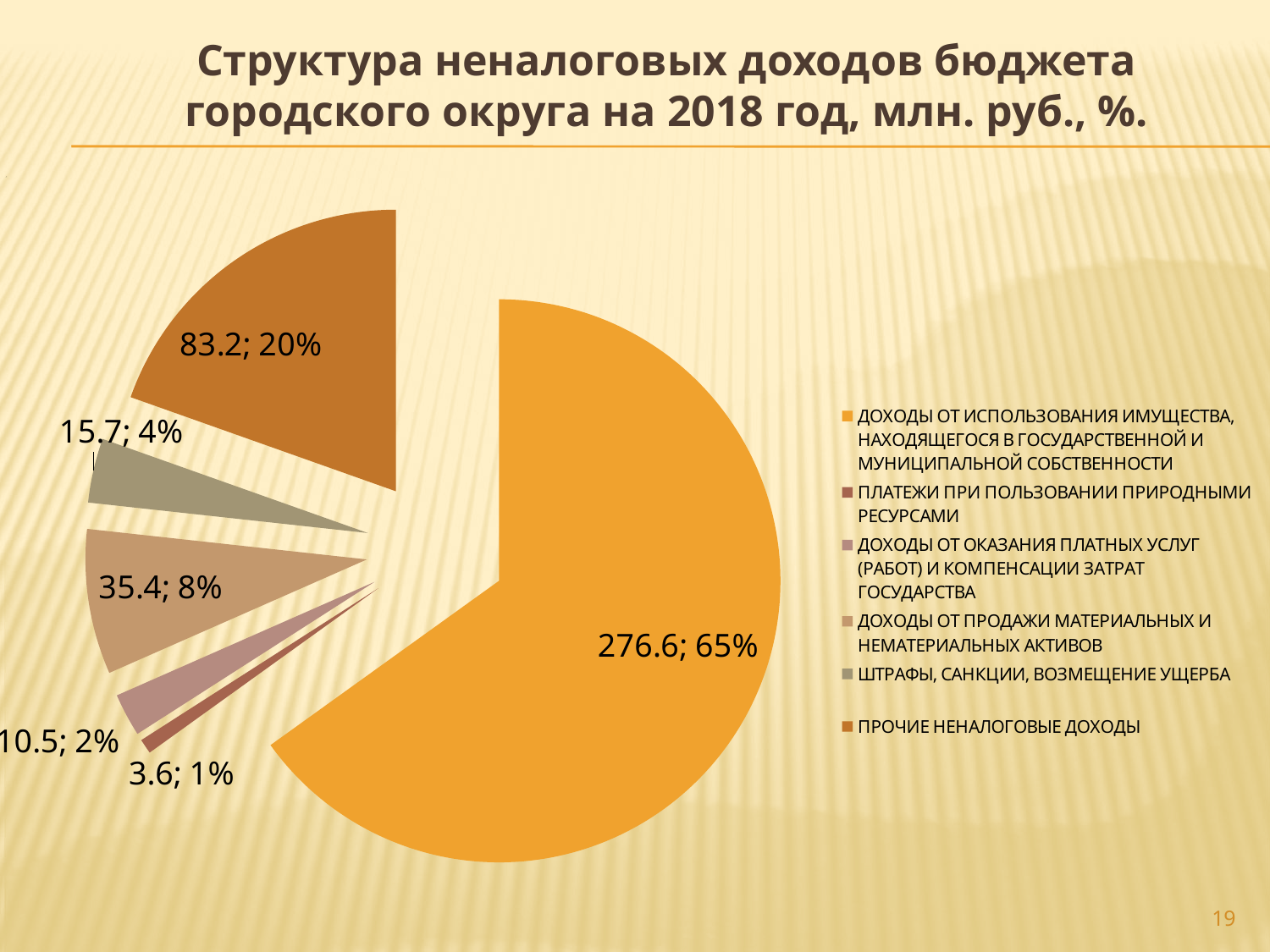
How many slices does the pie chart have? 6 Which category has the largest slice of the pie? Доходы от использования имущества, находящегося в государственной и муниципальной собственности What value is shown for the slice 'Прочие неналоговые доходы'? 83.2; 20% What value is shown for the slice 'Доходы от продажи материальных и нематериальных активов'? 35.4; 8% What value is shown for the slice 'Штрафы, санкции, возмещение ущерба'? 15.7; 4% What share of the pie does 'Платежи при пользовании природными ресурсами' take? 1% What value is shown for the slice 'Доходы от использования имущества, находящегося в государственной и муниципальной собственности'? 276.6; 65% Which is larger: 'Штрафы, санкции, возмещение ущерба' or 'Доходы от оказания платных услуг (работ) и компенсации затрат государства'? Штрафы, санкции, возмещение ущерба What is the difference in million rubles between 'Прочие неналоговые доходы' and 'Доходы от продажи материальных и нематериальных активов'? 47.8 Which category has the smallest slice of the pie? Платежи при пользовании природными ресурсами What kind of chart is shown on the slide? Pie chart What share of the pie does 'Доходы от оказания платных услуг (работ) и компенсации затрат государства' take? 2%